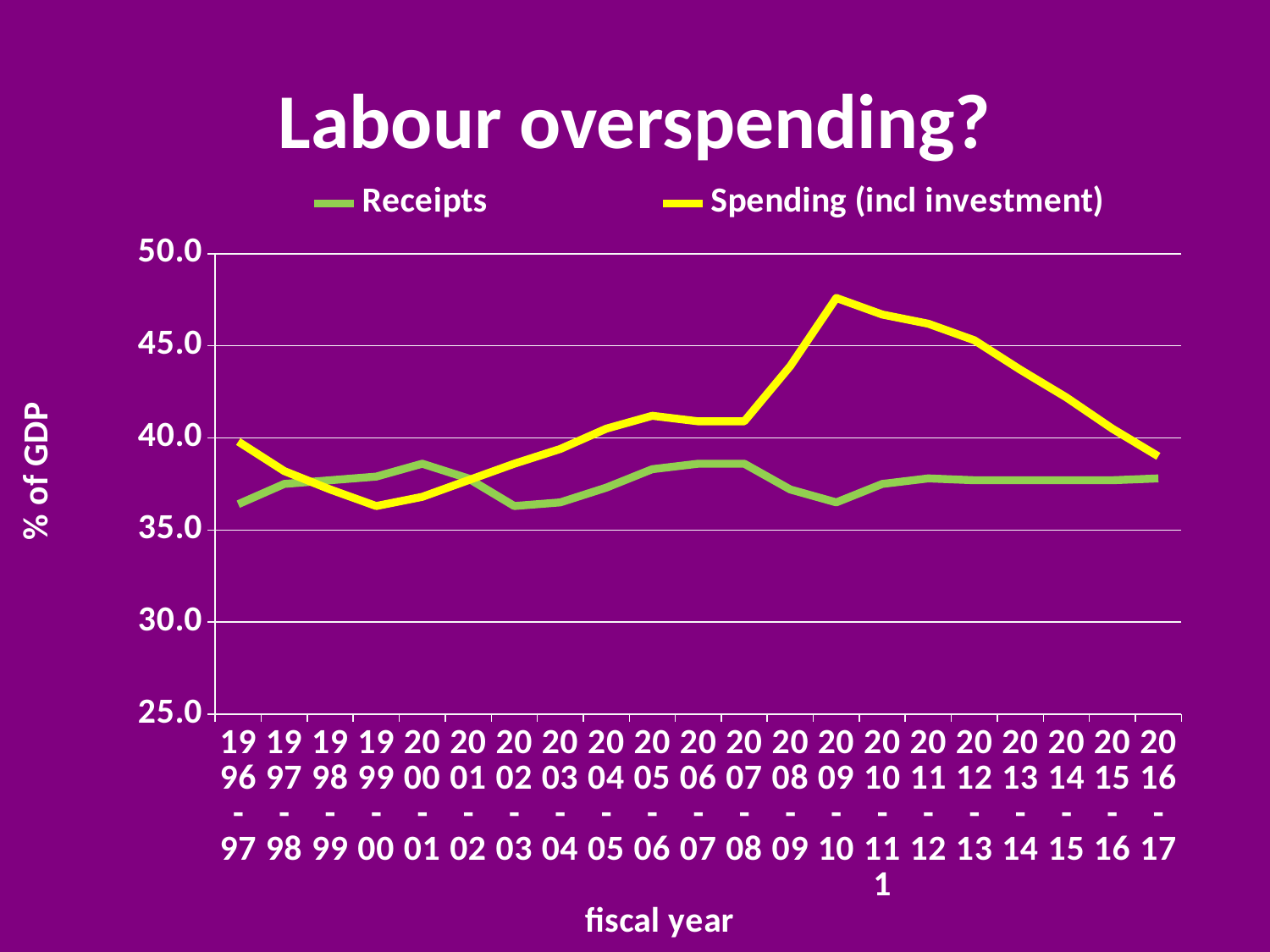
What kind of chart is shown on the slide? line chart Is the value for Receipts in 2016-17 greater or less than 40.0? less In which fiscal year does Spending (incl investment) reach its highest value? 2009-10 How many fiscal years are plotted along the x axis? 21 Is the value for Receipts in 2009-10 greater or less than 35.0? greater Does Spending (incl investment) rise or fall from 2009-10 to 2016-17? fall How many series does the legend list? 2 Is the value for Spending (incl investment) in 1999-00 greater or less than 40.0? less What is the title of the y axis? % of GDP In 2009-10, which is larger: Receipts or Spending (incl investment)? Spending (incl investment) In 1999-00, which is larger: Receipts or Spending (incl investment)? Receipts